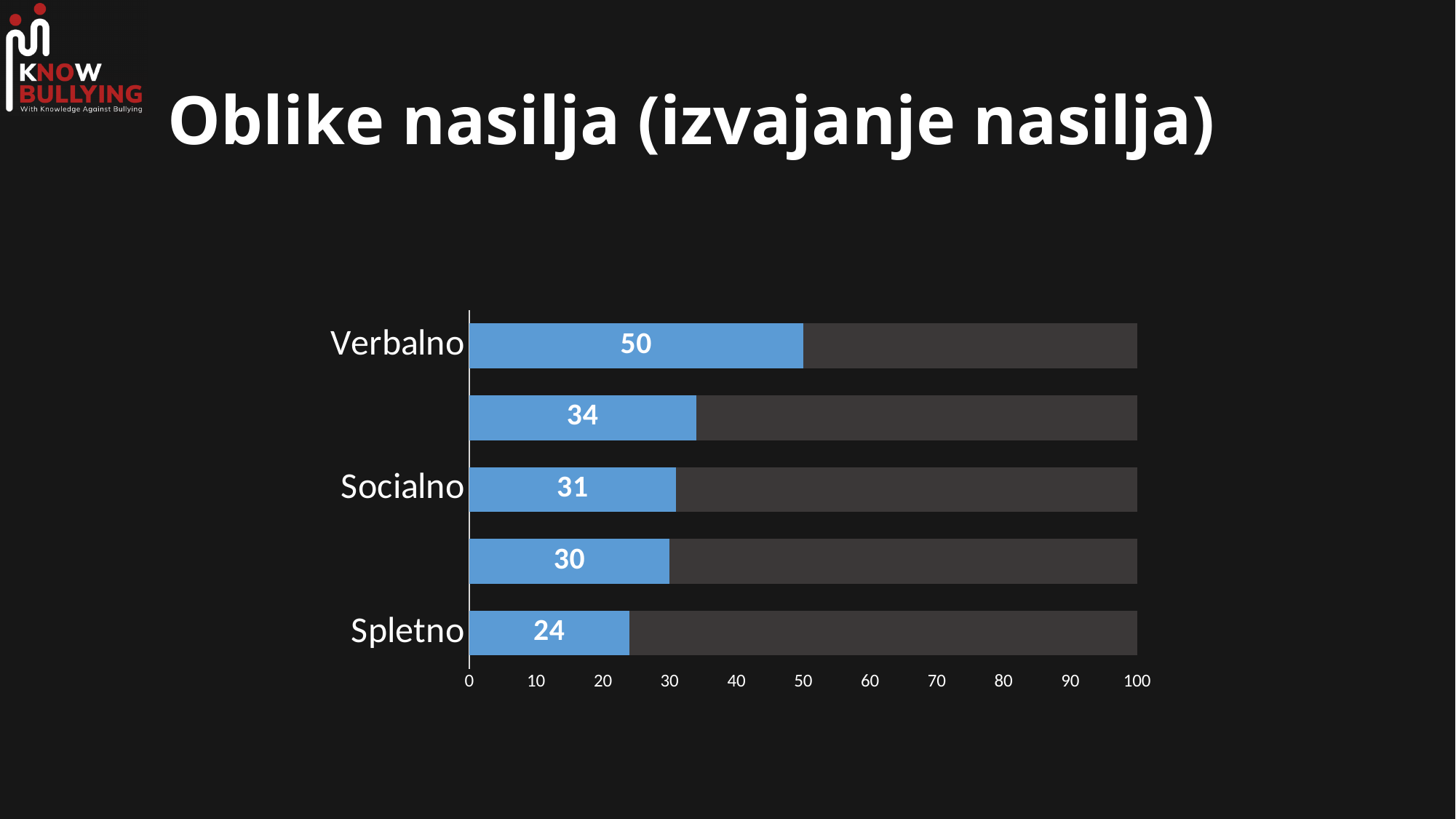
What is the difference between the values for Socialno and Spletno? 7 What is the value for Verbalno? 50 Is the value for Verbalno greater or less than 40? greater What is the title of the slide? Oblike nasilja (izvajanje nasilja) What is the value for Spletno? 24 Which category has the lowest value? Spletno Which is larger, the value for Verbalno or the value for Socialno? Verbalno How many bars are plotted in the chart? 5 What kind of chart is shown on the slide? bar chart What is the difference between the values for Verbalno and Spletno? 26 Which category has the highest value? Verbalno What is the value for Socialno? 31